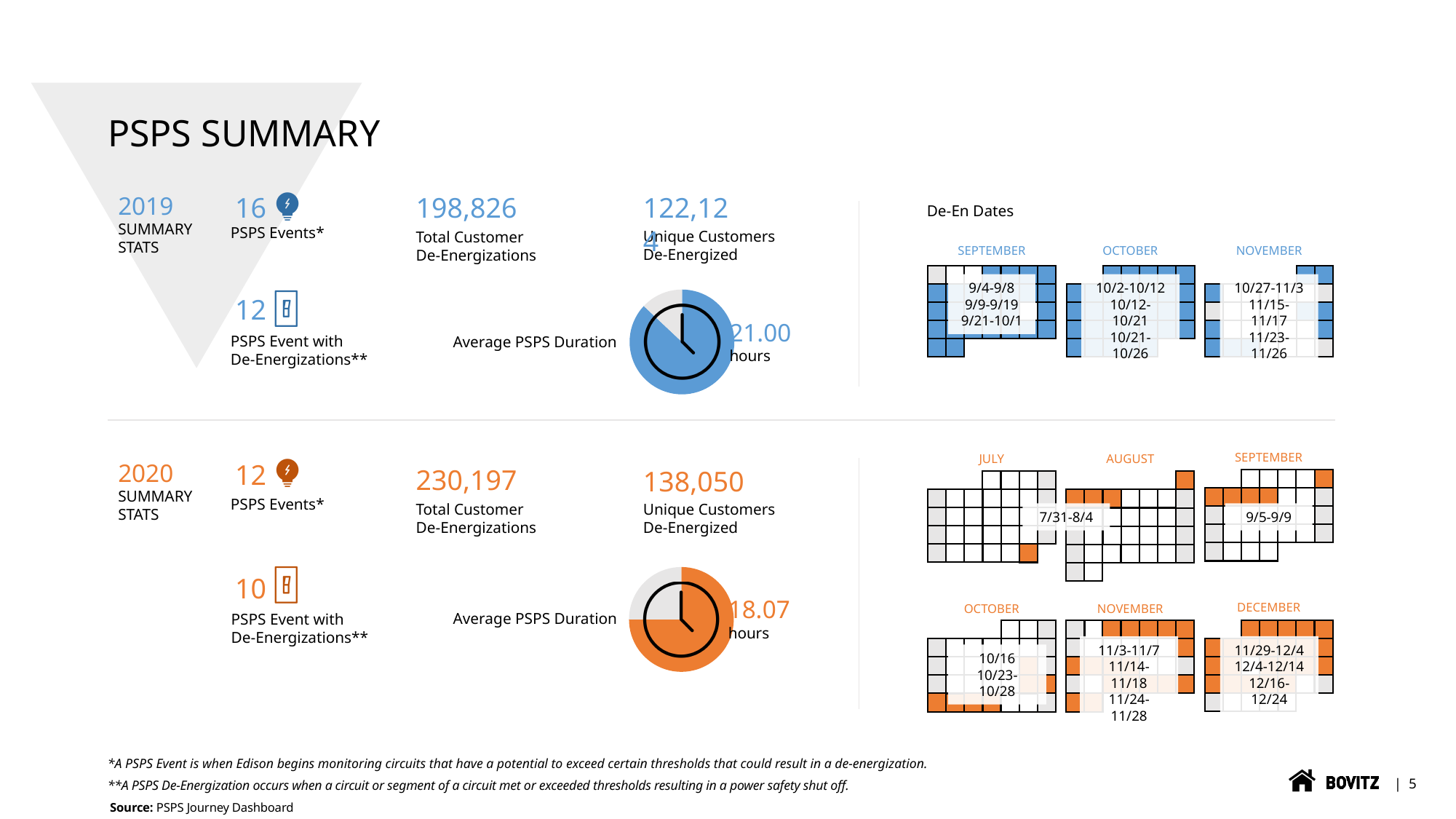
Which year's Average PSPS Duration chart shows the larger value, 2019 or 2020? 2019 Which month is shown first in the 2019 De-En Dates calendars? September On the 2020 Average PSPS Duration clock chart, what value is shown? 18.07 hours What is the difference in hours between the 2019 and 2020 Average PSPS Duration values? 2.93 hours What kind of chart is used to show the Average PSPS Duration for each year? pie chart How many months are shown in the 2019 De-En Dates calendar section? 3 On the 2019 Average PSPS Duration clock chart, what value is shown? 21.00 hours How many months are shown in the 2020 De-En Dates calendar section? 6 What colour is the filled portion of the 2020 Average PSPS Duration chart? orange